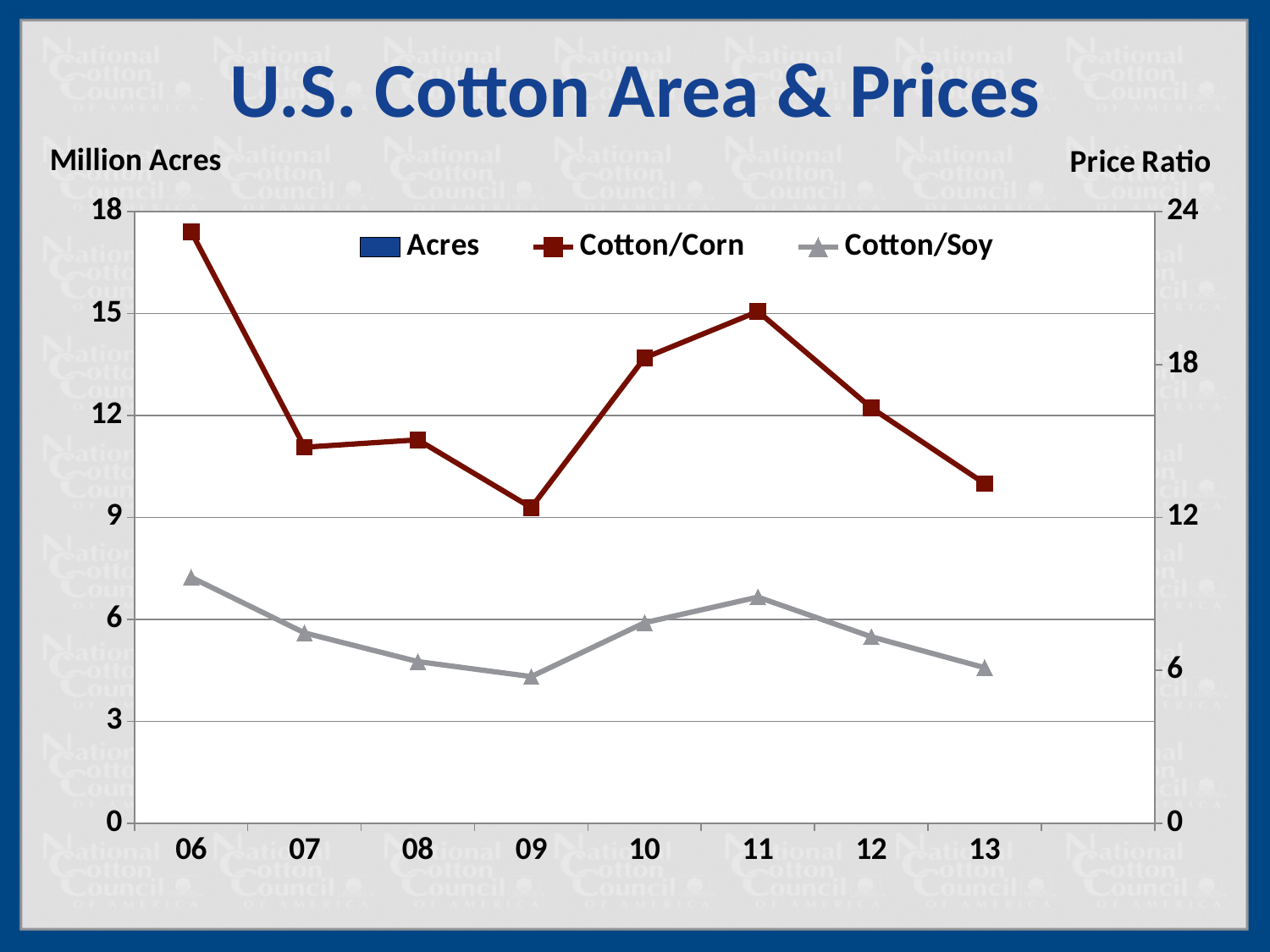
Does the Cotton/Corn line rise or fall from 11 to 13? fall In which year is the Cotton/Corn price ratio highest? 06 How many series does the legend list? 3 Is the Cotton/Corn value for 10 greater or less than 12? greater In which year is the Cotton/Corn price ratio lowest? 09 Which is larger, the Cotton/Corn value for 10 or for 12? 10 In which year is the Cotton/Soy price ratio highest? 06 What is the title of the chart? U.S. Cotton Area & Prices Which is larger, the Cotton/Soy value for 10 or for 11? 11 Is the Cotton/Corn value for 06 greater or less than 15? greater How many years are shown on the x axis? 8